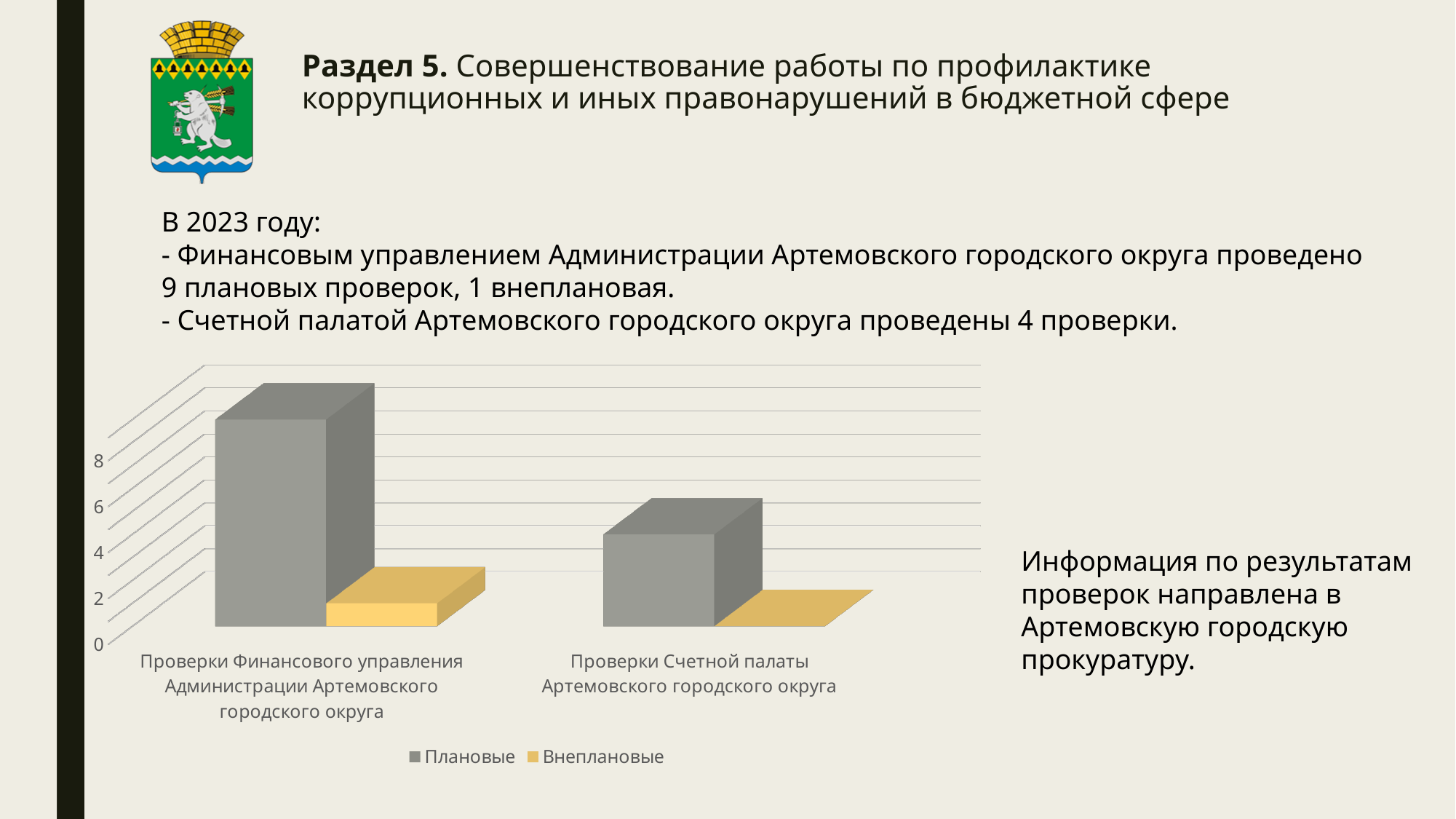
For Проверки Финансового управления Администрации Артемовского городского округа, which series has the larger value, Плановые or Внеплановые? Плановые Which category has the higher Плановые value? Проверки Финансового управления Администрации Артемовского городского округа How many series does the chart legend list? 2 What kind of chart is shown on the slide? bar chart Which series are listed in the chart legend? Плановые, Внеплановые Is the Плановые value for Проверки Счетной палаты Артемовского городского округа greater or less than 6? less Is the Плановые value for Проверки Финансового управления Администрации Артемовского городского округа greater or less than 6? greater Is the Внеплановые value for Проверки Финансового управления Администрации Артемовского городского округа greater or less than 2? less What colour represents the Внеплановые series in the chart? yellow Which category has the lower Плановые value? Проверки Счетной палаты Артемовского городского округа How many categories are shown on the x axis of the chart? 2